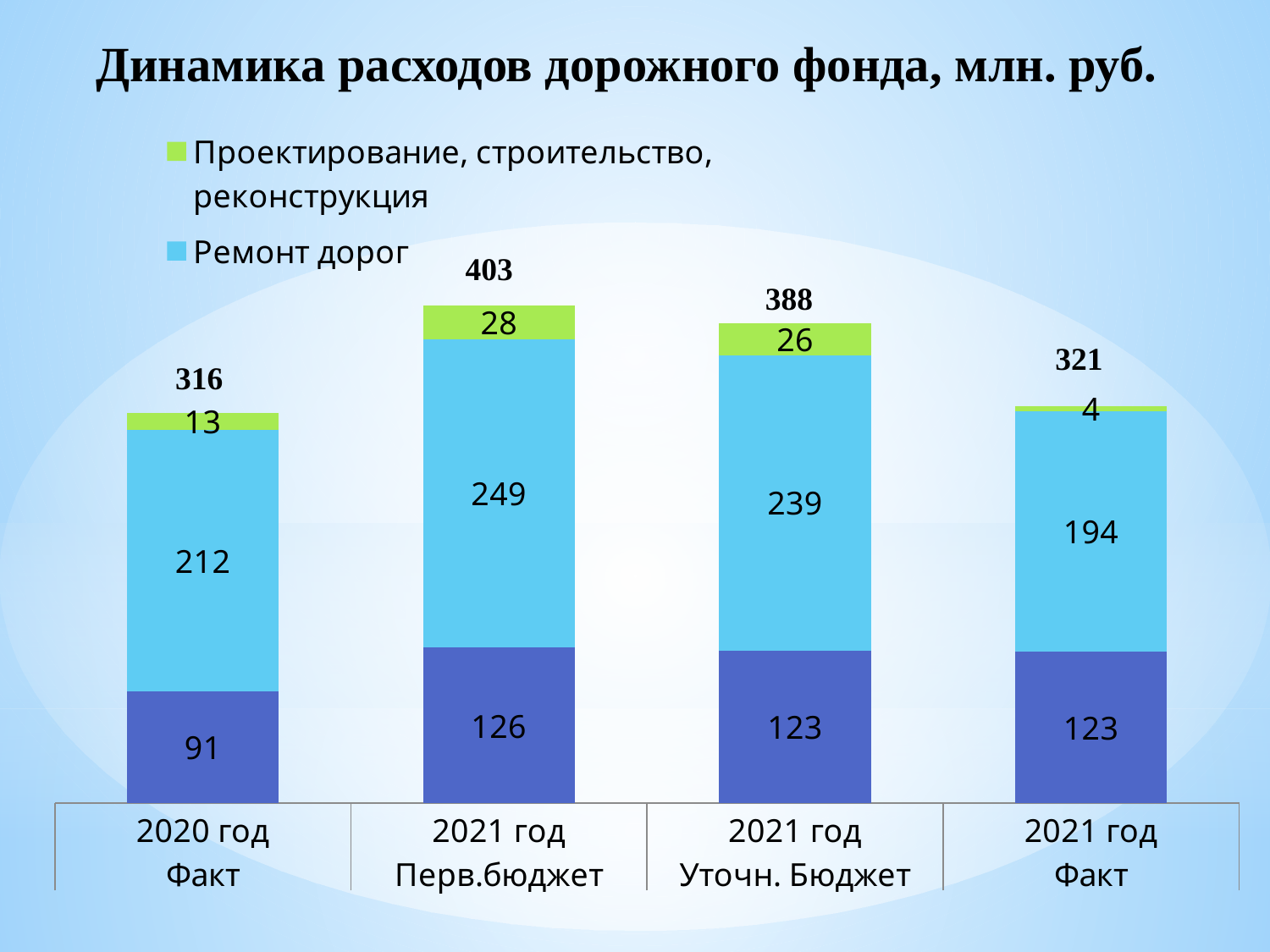
What is the difference between the totals for 2021 год Перв.бюджет and 2021 год Уточн. Бюджет? 15 What kind of chart is shown on the slide? Stacked bar chart Which category has the highest total? 2021 год Перв.бюджет How many series does the legend list? 2 Which category has the lowest total? 2020 год Факт What is the value of Проектирование, строительство, реконструкция for 2021 год Перв.бюджет? 28 Which is larger, the Проектирование, строительство, реконструкция value for 2020 год Факт or for 2021 год Факт? 2020 год Факт What is the difference between the Ремонт дорог values for 2021 год Перв.бюджет and 2021 год Факт? 55 What is the total of the stacked bar for 2021 год Уточн. Бюджет? 388 How many categories are shown on the x axis? 4 What is the value of Ремонт дорог for 2020 год Факт? 212 What is the value of Ремонт дорог for 2021 год Уточн. Бюджет? 239